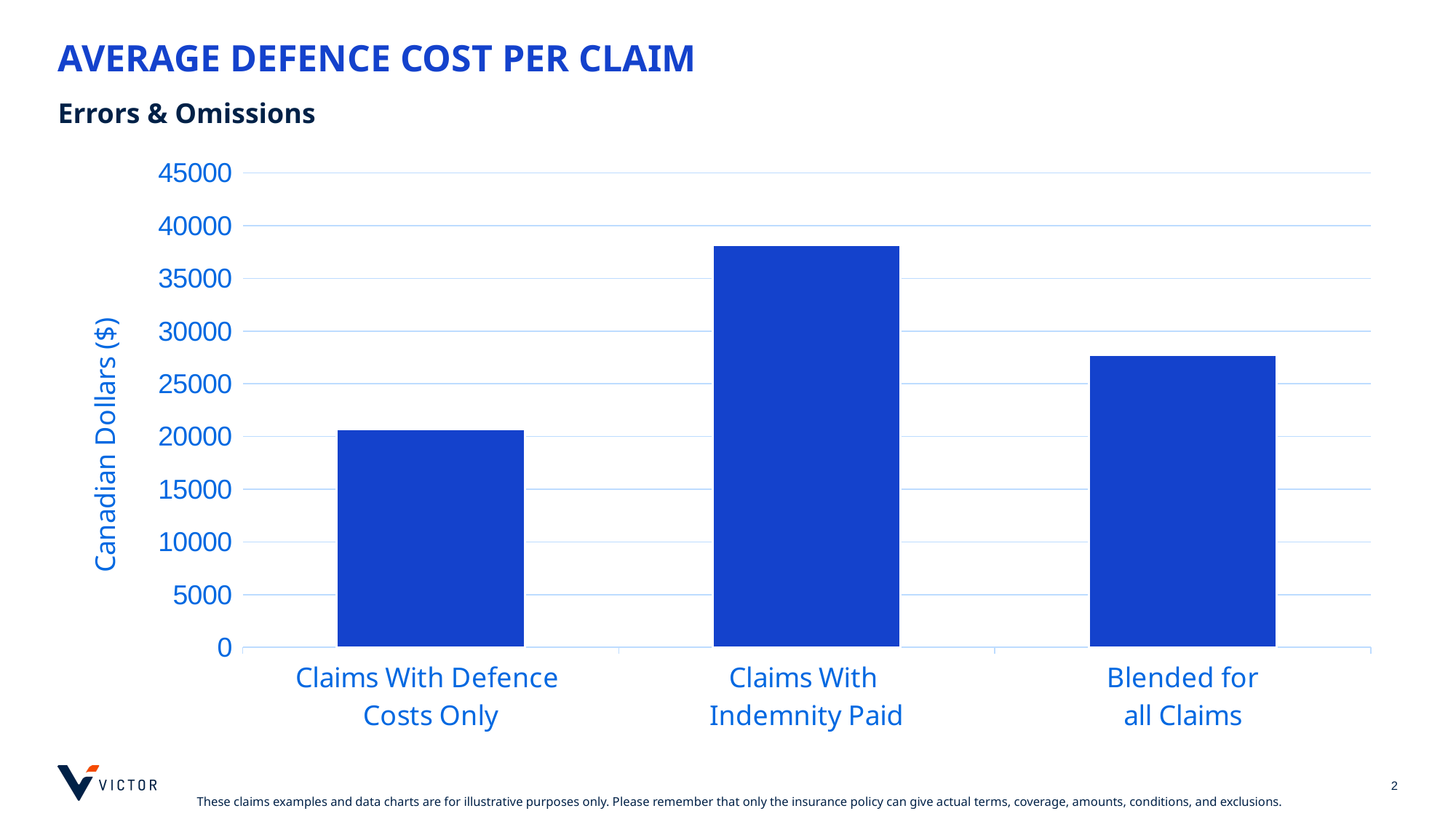
Is the value for Blended for all Claims greater or less than 25000? greater Is the value for Blended for all Claims greater or less than 30000? less How many categories are shown on the x axis of the chart? 3 What is the title of the chart on the slide? AVERAGE DEFENCE COST PER CLAIM Which is larger: the value for Claims With Defence Costs Only or the value for Blended for all Claims? Blended for all Claims Which category has the highest average defence cost per claim? Claims With Indemnity Paid Is the value for Claims With Defence Costs Only greater or less than 25000? less What is the label of the vertical axis of the chart? Canadian Dollars ($) Which category has the lowest average defence cost per claim? Claims With Defence Costs Only Which is larger: the value for Claims With Indemnity Paid or the value for Blended for all Claims? Claims With Indemnity Paid What type of chart is shown on the slide? bar chart